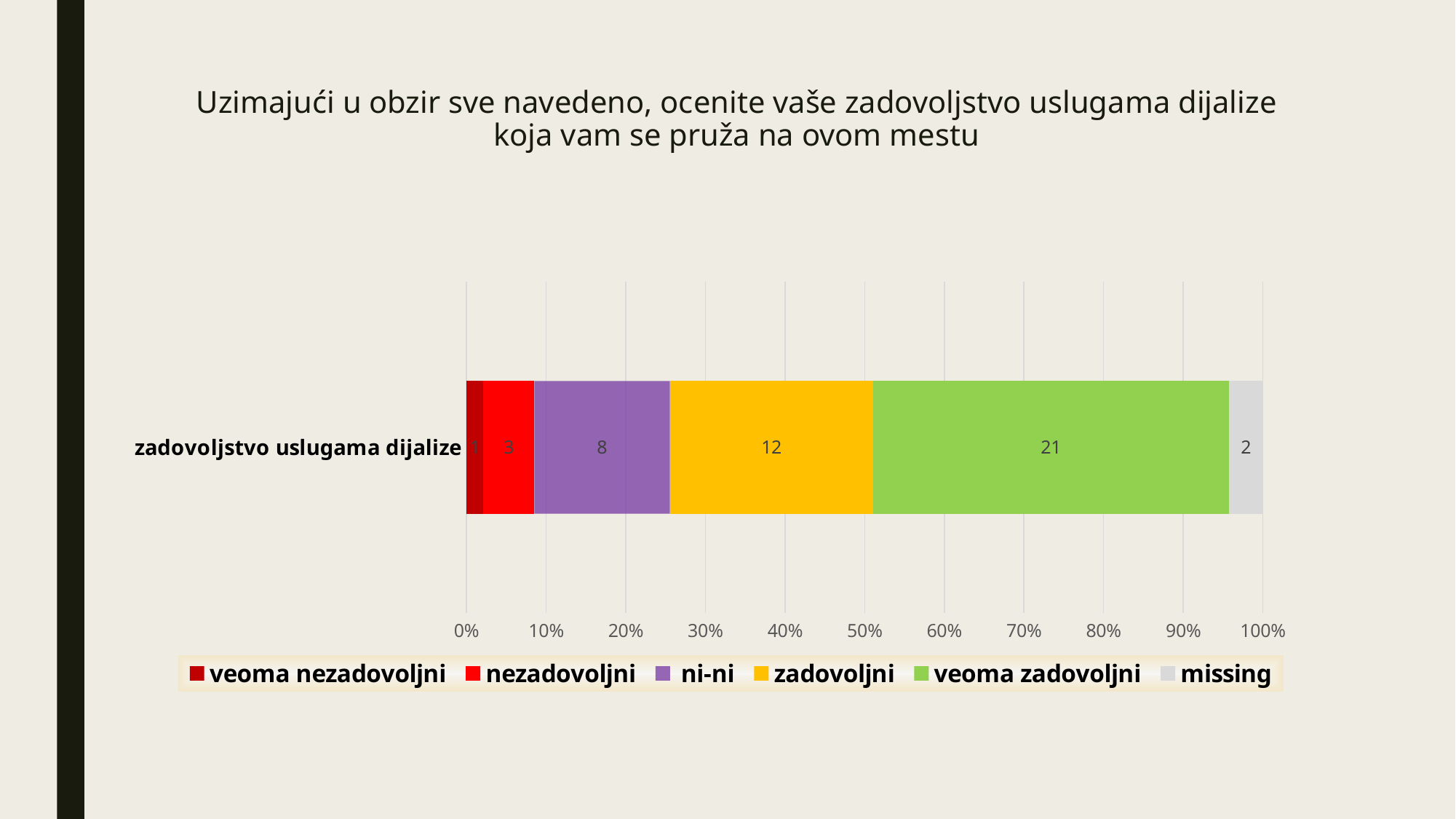
What is the total of all segments in the stacked bar? 47 What type of chart is shown on the slide? bar chart What is the value for "ni-ni" in the bar? 8 What is the value for "missing" in the bar? 2 How many categories are plotted on the vertical axis? 1 Which series has the largest value in the bar? veoma zadovoljni What is the value for "veoma zadovoljni" in the bar? 21 Which series has the smallest value in the bar? veoma nezadovoljni Which is larger, the value for "nezadovoljni" or the value for "ni-ni"? ni-ni What is the value for "zadovoljni" in the bar? 12 What is the difference between the values for "veoma zadovoljni" and "zadovoljni"? 9 How many series does the legend list? 6